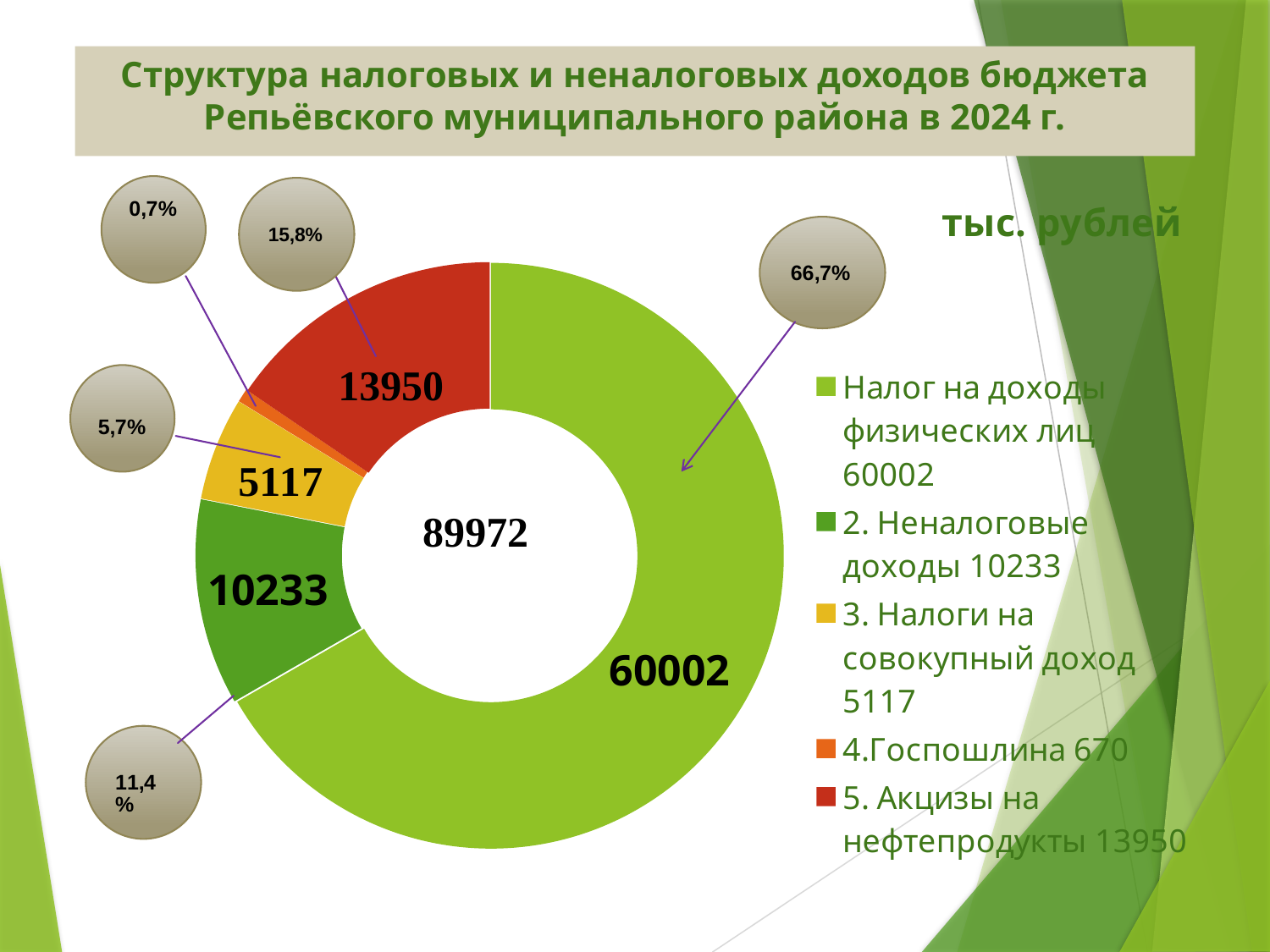
Which category has the largest value? Налог на доходы физических лиц What is the difference between Акцизы на нефтепродукты and Неналоговые доходы? 3717 How many categories does the chart show? 5 What is the value for Неналоговые доходы? 10233 Which is larger, Неналоговые доходы or Налоги на совокупный доход? Неналоговые доходы What is the value for Налоги на совокупный доход? 5117 What is the value for Налог на доходы физических лиц? 60002 What is the value for Акцизы на нефтепродукты? 13950 Which category has the smallest value? Госпошлина What type of chart is shown on the slide? Doughnut (pie) chart What is the value for Госпошлина? 670 What share of the total does Акцизы на нефтепродукты represent, as shown on the slide? 15,8%